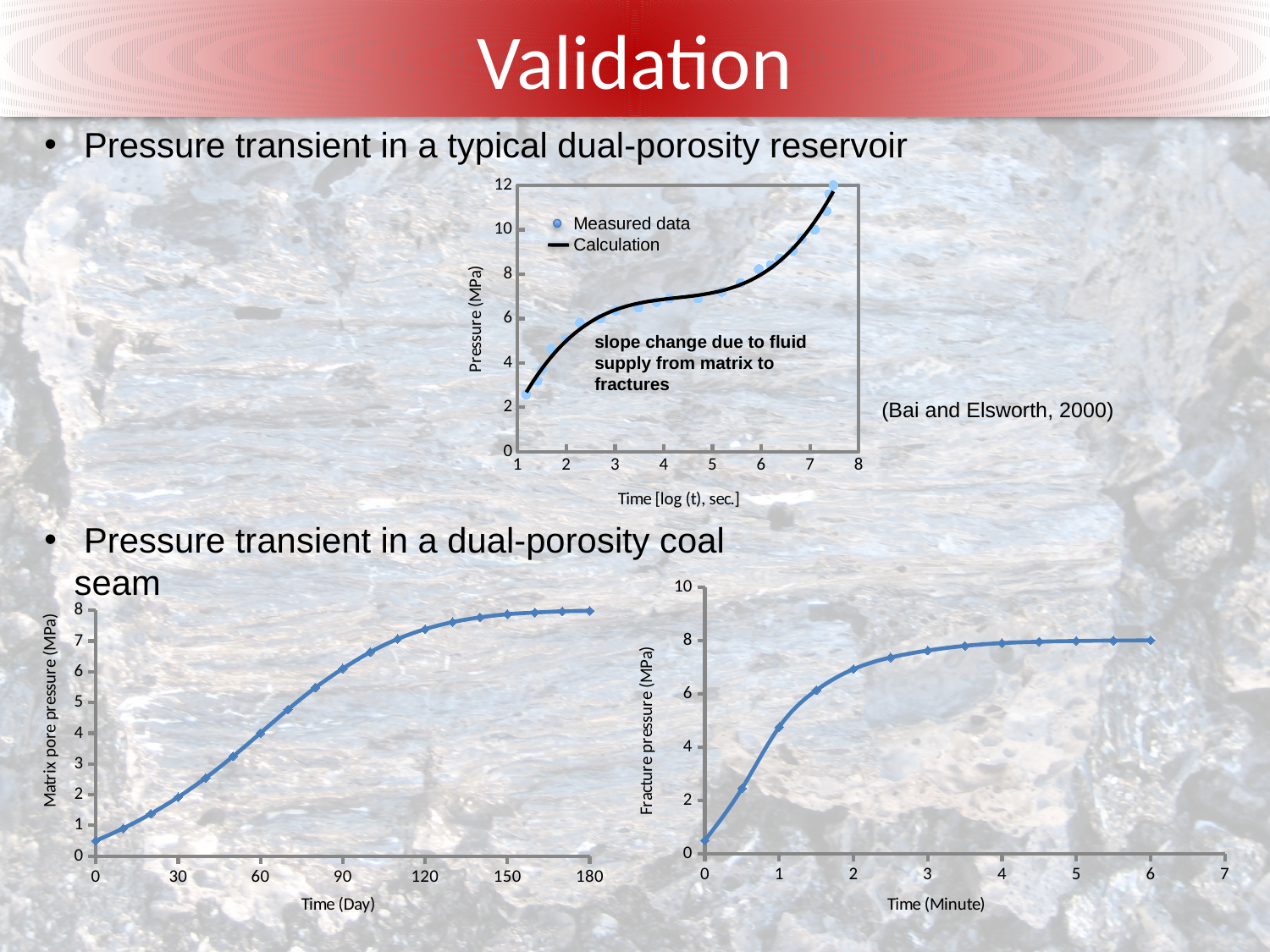
In the bottom-left chart (Matrix pore pressure vs Time (Day)), does the matrix pore pressure rise or fall over time? rise In the bottom-right chart (Fracture pressure vs Time (Minute)), is the value at 1 minute greater or less than 4? greater What is the y-axis title of the bottom-right chart? Fracture pressure (MPa) How many series does the legend of the top chart (Pressure vs Time [log (t), sec.]) list? 2 In the bottom-left chart (Matrix pore pressure vs Time (Day)), is the value at 30 days greater or less than 3? less In the bottom-left chart (Matrix pore pressure vs Time (Day)), is the value at 120 days greater or less than 7? greater What are the two legend entries in the top chart? Measured data; Calculation What kind of chart is the bottom-left chart with the x axis 'Time (Day)'? line chart In the top chart (Pressure vs Time [log (t), sec.]), does the pressure rise or fall as log(t) increases? rise